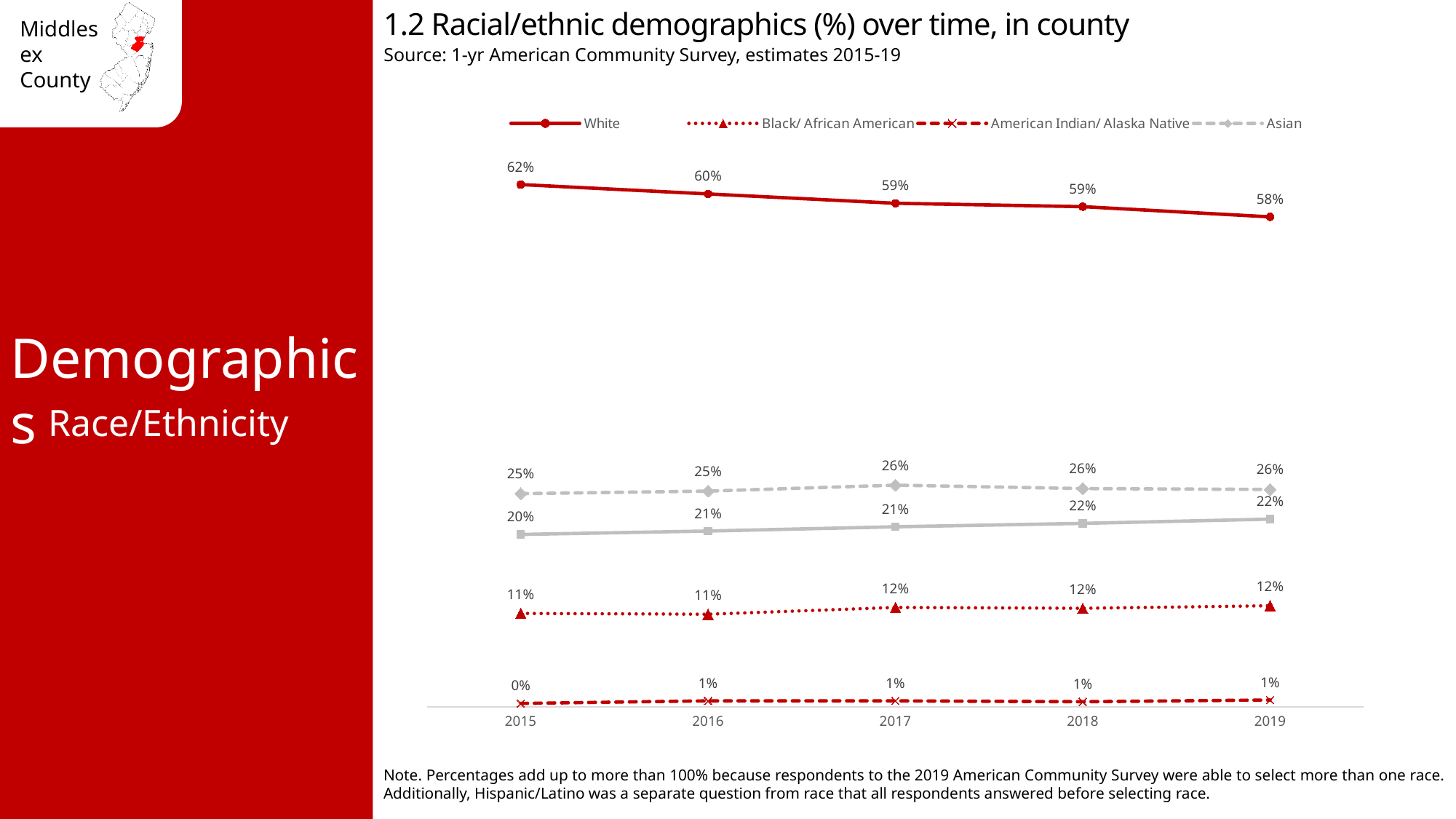
What was the White percentage in 2015? 62% What was the American Indian/ Alaska Native percentage in 2015? 0% What was the White percentage in 2019? 58% What was the Asian percentage in 2017? 26% How many years are shown on the x axis? 5 What type of chart is shown on the slide? line chart Which year has the highest White percentage? 2015 Does the White series rise or fall from 2015 to 2019? fall Which is larger in 2019, the Asian percentage or the Black/ African American percentage? Asian By how many percentage points did the White share fall from 2015 to 2019? 4 What was the Black/ African American percentage in 2016? 11% How many series does the legend list? 4